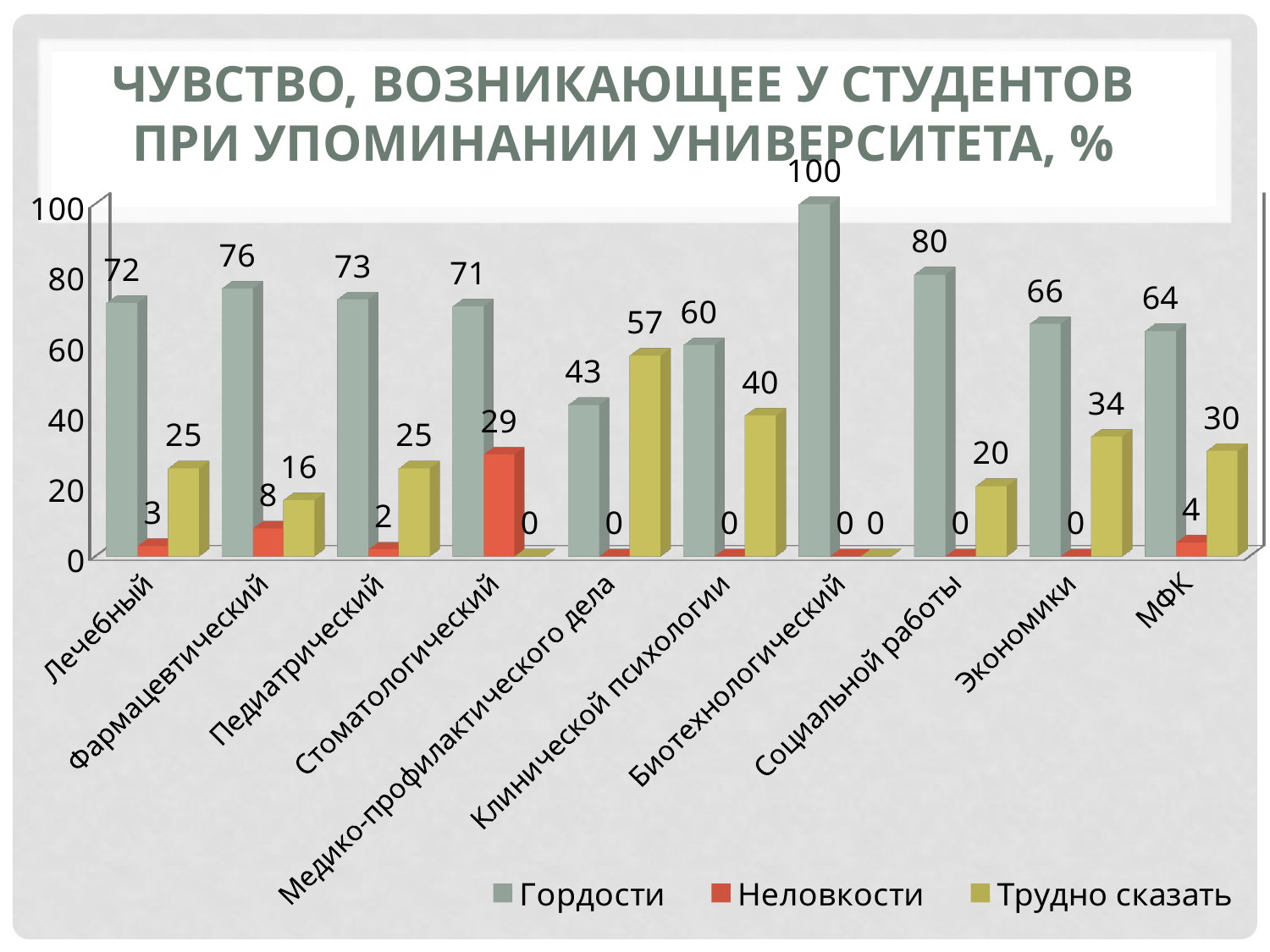
What is the value of Трудно сказать for Медико-профилактического дела? 57 How many series does the legend list? 3 Which is larger: the Трудно сказать value for Экономики or for МФК? Экономики What is the difference between the Гордости values for Социальной работы and Экономики? 14 What type of chart is shown on the slide? bar chart What is the value of Неловкости for Стоматологический? 29 How many faculties (categories) are shown on the x axis? 10 Which series is shown in red in the legend? Неловкости Which faculty has the lowest value for Гордости? Медико-профилактического дела Which faculty has the highest value for Неловкости? Стоматологический Which faculty has the highest value for Гордости? Биотехнологический What is the value of Гордости for Биотехнологический? 100